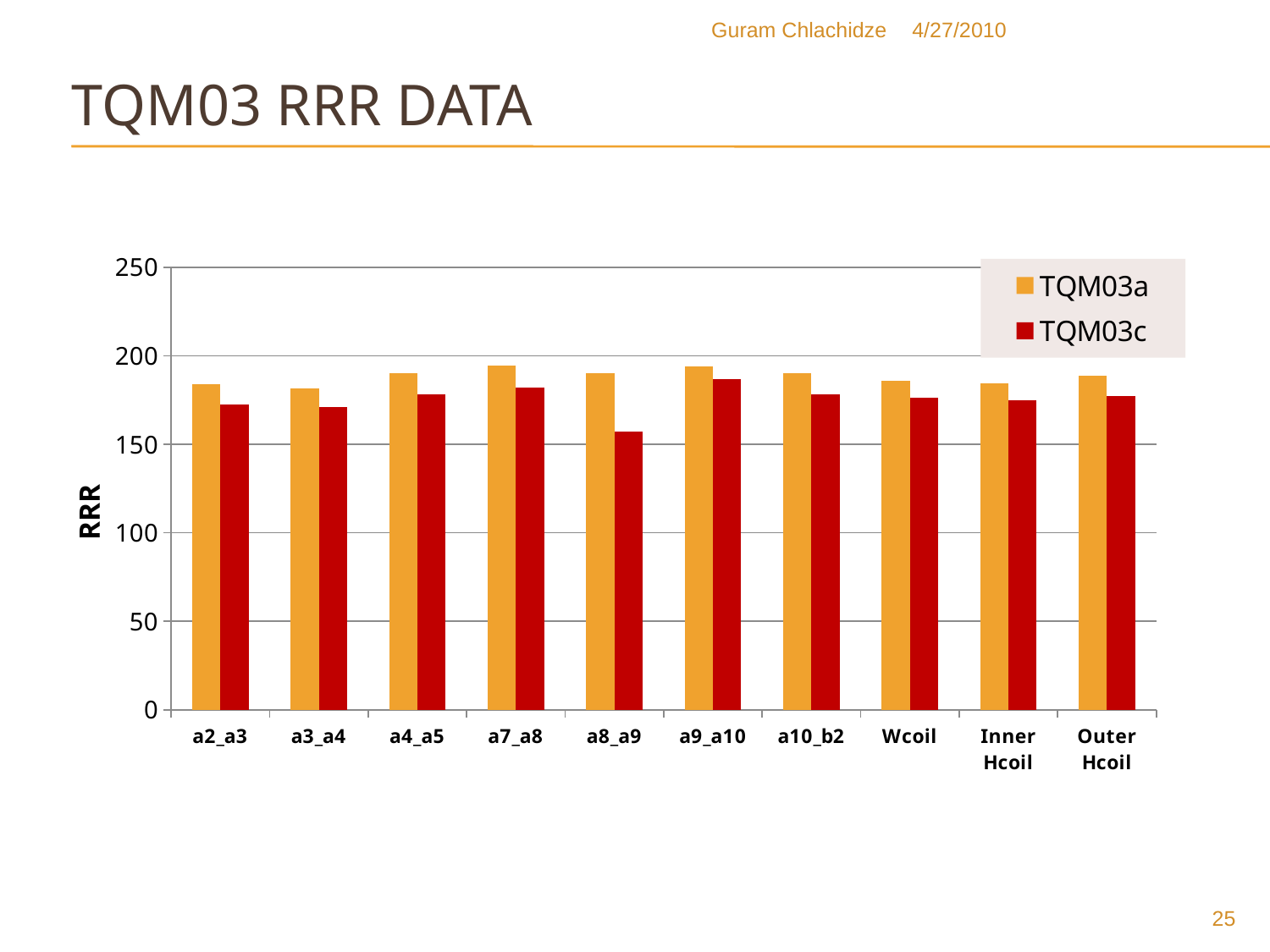
Is the TQM03c value for a8_a9 greater or less than 150? greater What is the label on the vertical axis? RRR How many categories are shown along the x axis? 10 Which series is drawn in red? TQM03c What kind of chart is shown on the slide? bar chart For a8_a9, which series has the larger value, TQM03a or TQM03c? TQM03a Is the TQM03a value for Wcoil greater or less than 150? greater Which is larger: the TQM03c value for a2_a3 or the TQM03c value for a8_a9? a2_a3 Is the TQM03a value for a7_a8 greater or less than 200? less How many series does the legend list? 2 Which category has the lowest TQM03c value? a8_a9